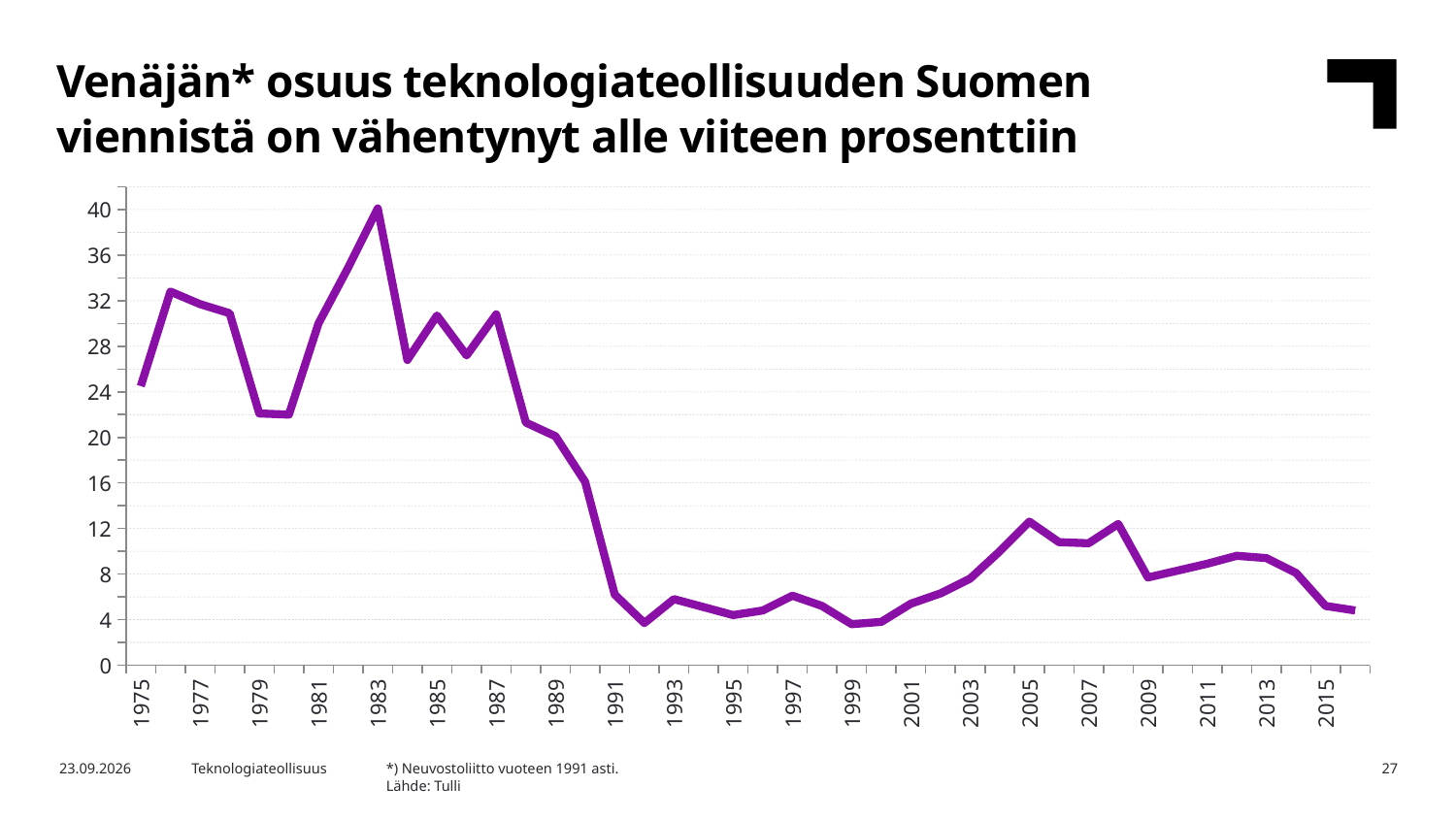
Is the value for 1987 greater or less than 28? greater In which year does the line reach its highest value? 1983 Is the value for 1983 greater or less than 36? greater Is the value for 2009 greater or less than 12? less Which year has the larger value, 1977 or 1979? 1977 What source is cited for the chart data? Tulli Which year has the larger value, 1983 or 1987? 1983 Overall, does the line rise or fall from 1975 to 2016? fall What kind of chart is shown on the slide? line chart